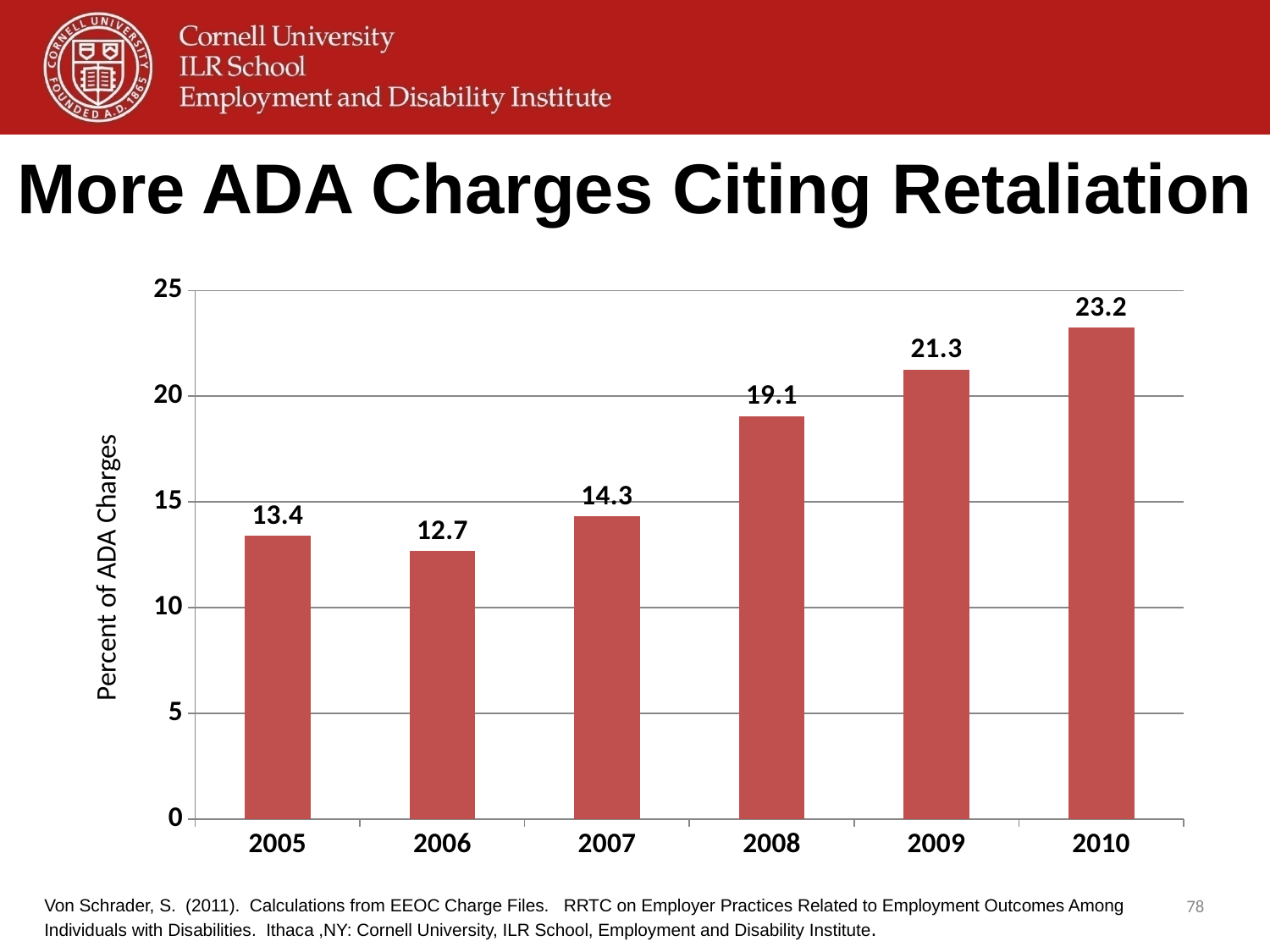
What is the difference between the values for 2010 and 2005? 9.8 Which year has the lowest percent of ADA charges citing retaliation? 2006 What is the difference between the values for 2009 and 2008? 2.2 How many years are shown on the x axis? 6 What is the value shown for 2005? 13.4 What is the label of the y axis? Percent of ADA Charges Is the value for 2009 greater or less than 20? greater Which year has the highest percent of ADA charges citing retaliation? 2010 What is the percent of ADA charges citing retaliation in 2008? 19.1 What is the value shown for 2010? 23.2 What kind of chart is shown on the slide? Bar chart Which year has a larger value, 2007 or 2006? 2007